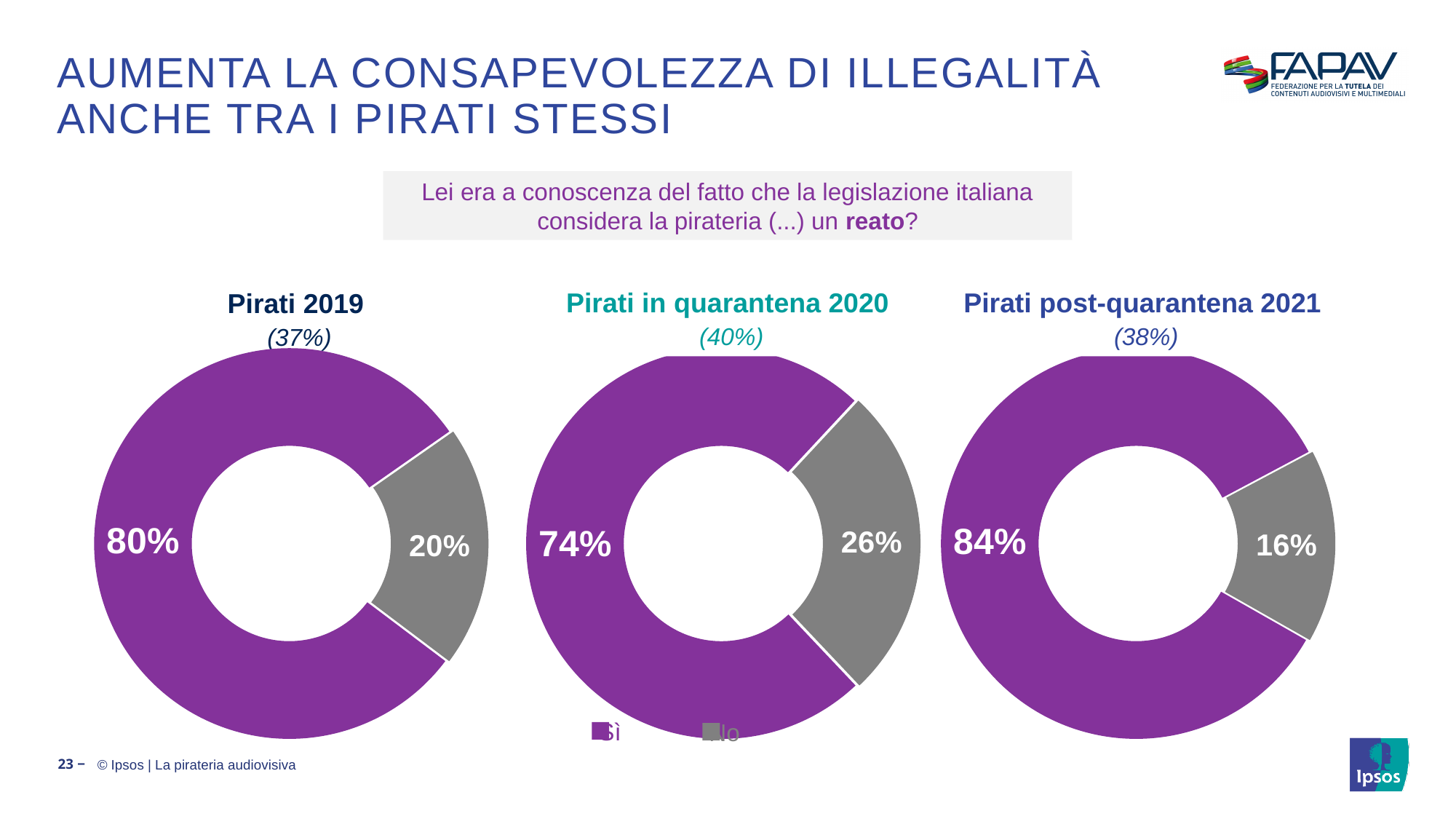
Across the three charts, which group has the highest share answering Sì? Pirati post-quarantena 2021 In the 'Pirati 2019' chart, what percentage answered Sì? 80% What is the difference between the Sì share in the 'Pirati post-quarantena 2021' chart and the Sì share in the 'Pirati 2019' chart? 4% Across the three charts, which group has the lowest share answering Sì? Pirati in quarantena 2020 In the 'Pirati in quarantena 2020' chart, what percentage answered No? 26% What kind of chart is used on this slide? Donut (pie) chart In the 'Pirati in quarantena 2020' chart, what is the difference between the Sì and No shares? 48% Which colour represents the Sì answer in the charts? Purple Is the No share larger in the 'Pirati 2019' chart or in the 'Pirati in quarantena 2020' chart? Pirati in quarantena 2020 In the 'Pirati post-quarantena 2021' chart, what percentage answered Sì? 84% In the 'Pirati post-quarantena 2021' chart, what percentage answered No? 16% How many donut charts are shown on the slide? 3